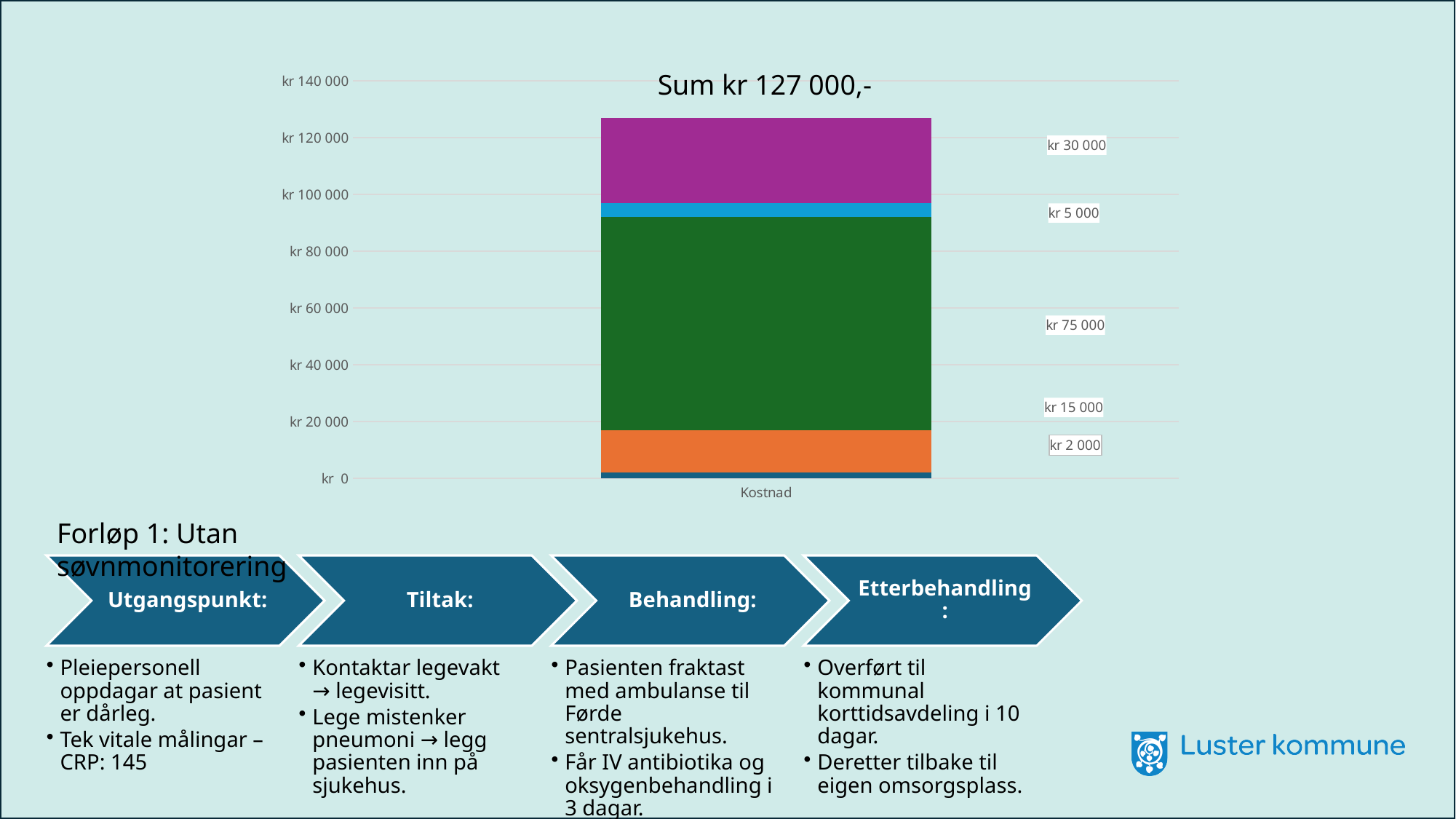
What is the value of the green segment of the bar? kr 75 000 What is the label of the single category on the x axis? Kostnad What kind of chart is shown on the slide? Stacked bar chart Which segment has the smallest value? The dark blue segment at the bottom (kr 2 000) What is the difference between the purple segment (kr 30 000) and the orange segment (kr 15 000)? kr 15 000 What is the title of the chart? Sum kr 127 000,- What is the value of the purple segment at the top of the bar? kr 30 000 How many categories are plotted on the x axis? 1 What is the total of the stacked bar for Kostnad? kr 127 000 Which segment has the largest value? The green segment (kr 75 000) How many segments make up the stacked bar? 5 Is the total height of the bar greater or less than kr 120 000? greater